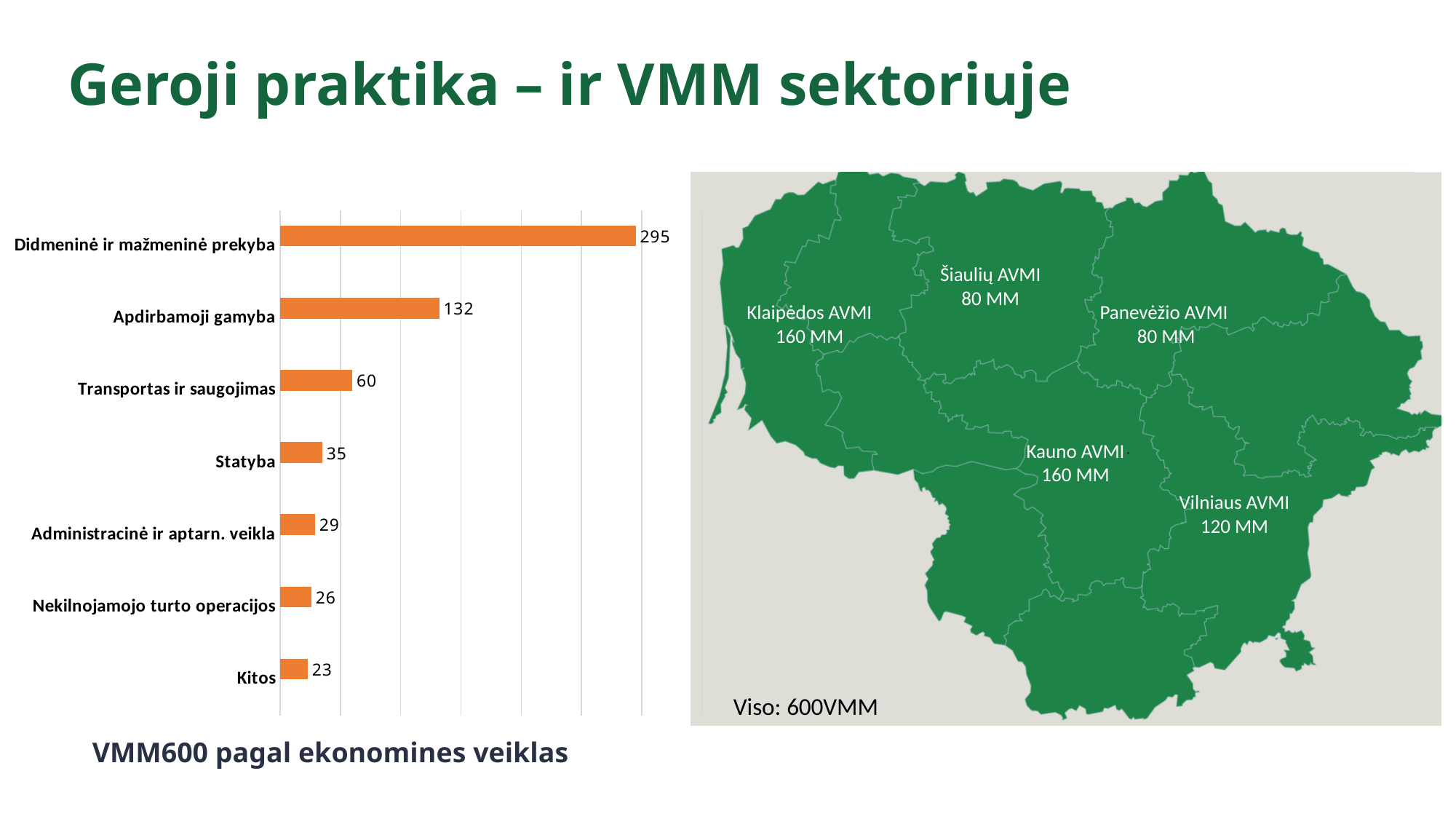
In the bar chart, what is the value for Statyba? 35 In the bar chart, what is the value for Transportas ir saugojimas? 60 Which category has the highest value in the bar chart? Didmeninė ir mažmeninė prekyba In the bar chart, what is the value for Nekilnojamojo turto operacijos? 26 What kind of chart is shown on the left of the slide? Bar chart In the bar chart, what is the difference between the values for Didmeninė ir mažmeninė prekyba and Apdirbamoji gamyba? 163 How many categories are shown in the bar chart? 7 In the bar chart, which is larger: the value for Statyba or the value for Administracinė ir aptarn. veikla? Statyba In the bar chart, what is the value for Apdirbamoji gamyba? 132 What is the caption printed below the bar chart? VMM600 pagal ekonomines veiklas Which category has the lowest value in the bar chart? Kitos In the bar chart, what is the value for Didmeninė ir mažmeninė prekyba? 295